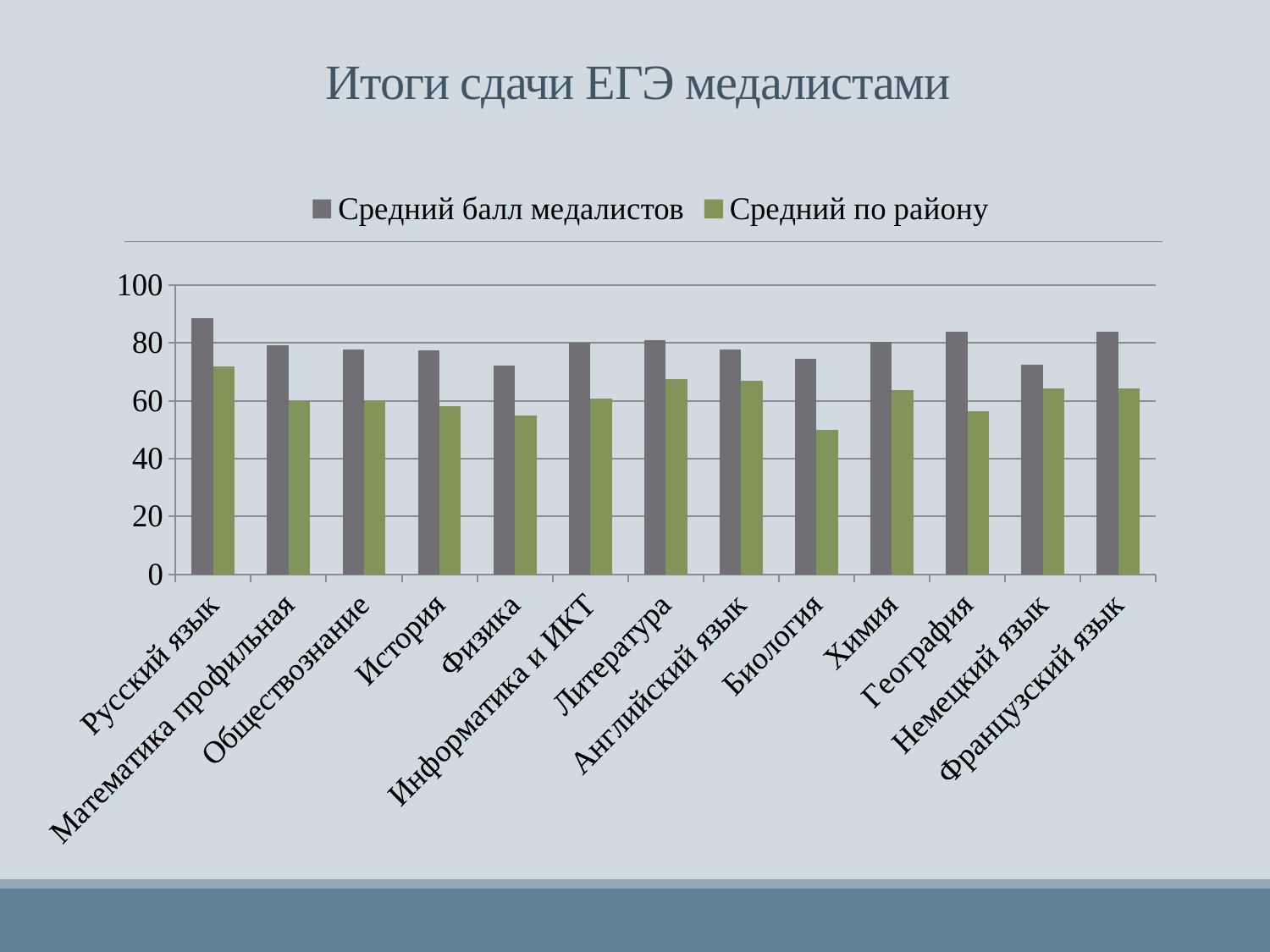
Is the value for Средний балл медалистов in География greater or less than 80? greater Which series is shown in green? Средний по району Is the value for Средний по району in Биология greater or less than 60? less What kind of chart is shown on the slide? bar chart Is the value for Средний балл медалистов in Русский язык greater or less than 80? greater How many series does the legend list? 2 Which subject has the highest value for Средний по району? Русский язык What is the title of the slide's chart? Итоги сдачи ЕГЭ медалистами Which subject has the highest value for Средний балл медалистов? Русский язык How many subjects (categories) are shown on the x axis? 13 Which is larger for Средний по району: Литература or Биология? Литература Which subject has the lowest value for Средний по району? Биология